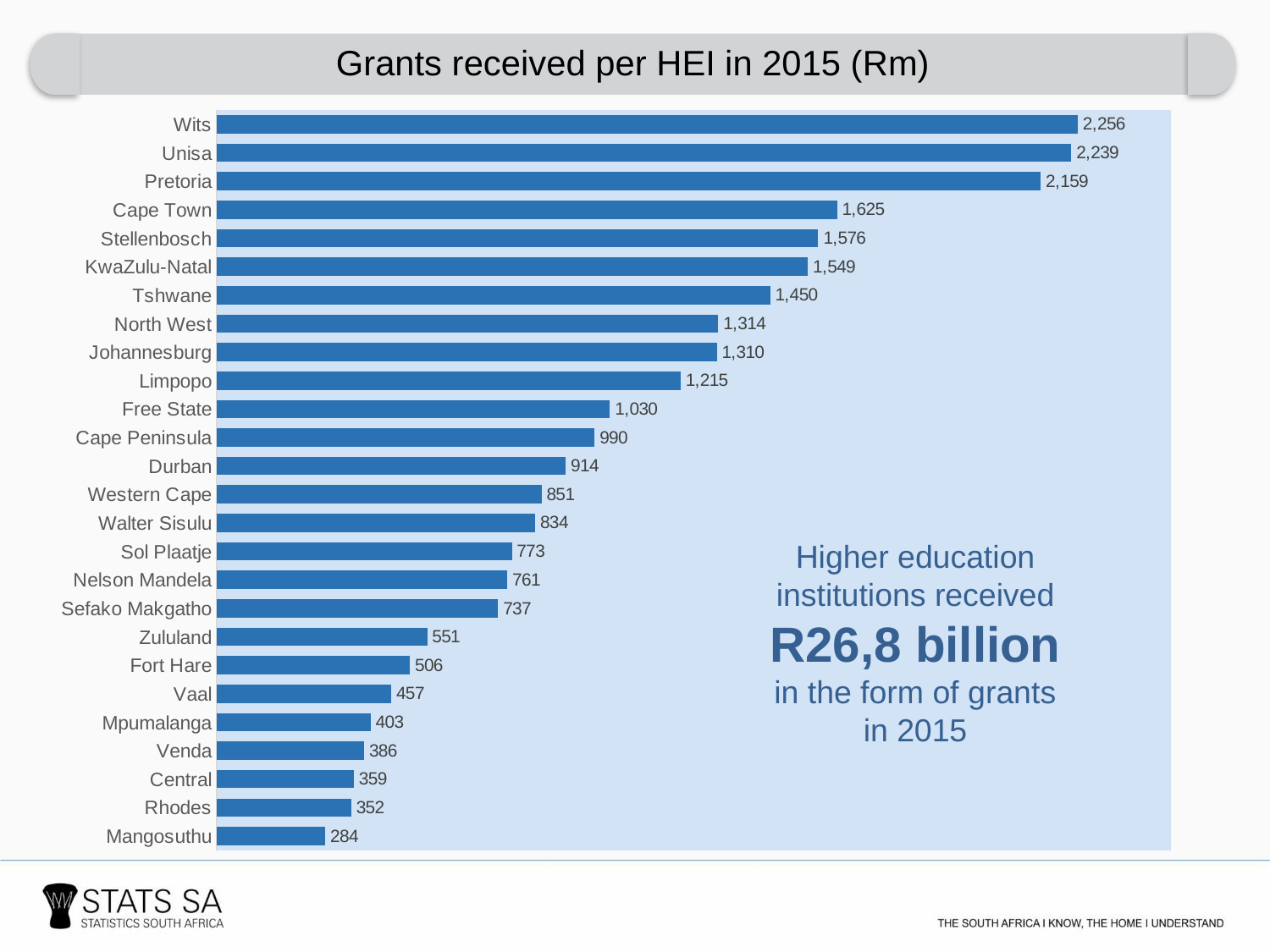
Which received more in grants, Durban or Cape Peninsula? Cape Peninsula What is the difference in grants (Rm) between Wits and Unisa? 17 What grant amount (Rm) is shown for Tshwane? 1,450 What is the difference in grants (Rm) between Cape Town and Stellenbosch? 49 What grant amount (Rm) is shown for Sefako Makgatho? 737 What grant amount (Rm) did Wits receive in 2015? 2,256 What type of chart is used on this slide? Bar chart How many institutions are shown in the chart? 26 Which institution received the highest grant amount in 2015? Wits According to the text on the slide, what total amount did higher education institutions receive in grants in 2015? R26,8 billion Which received more in grants, Zululand or Fort Hare? Zululand Which institution received the lowest grant amount in 2015? Mangosuthu